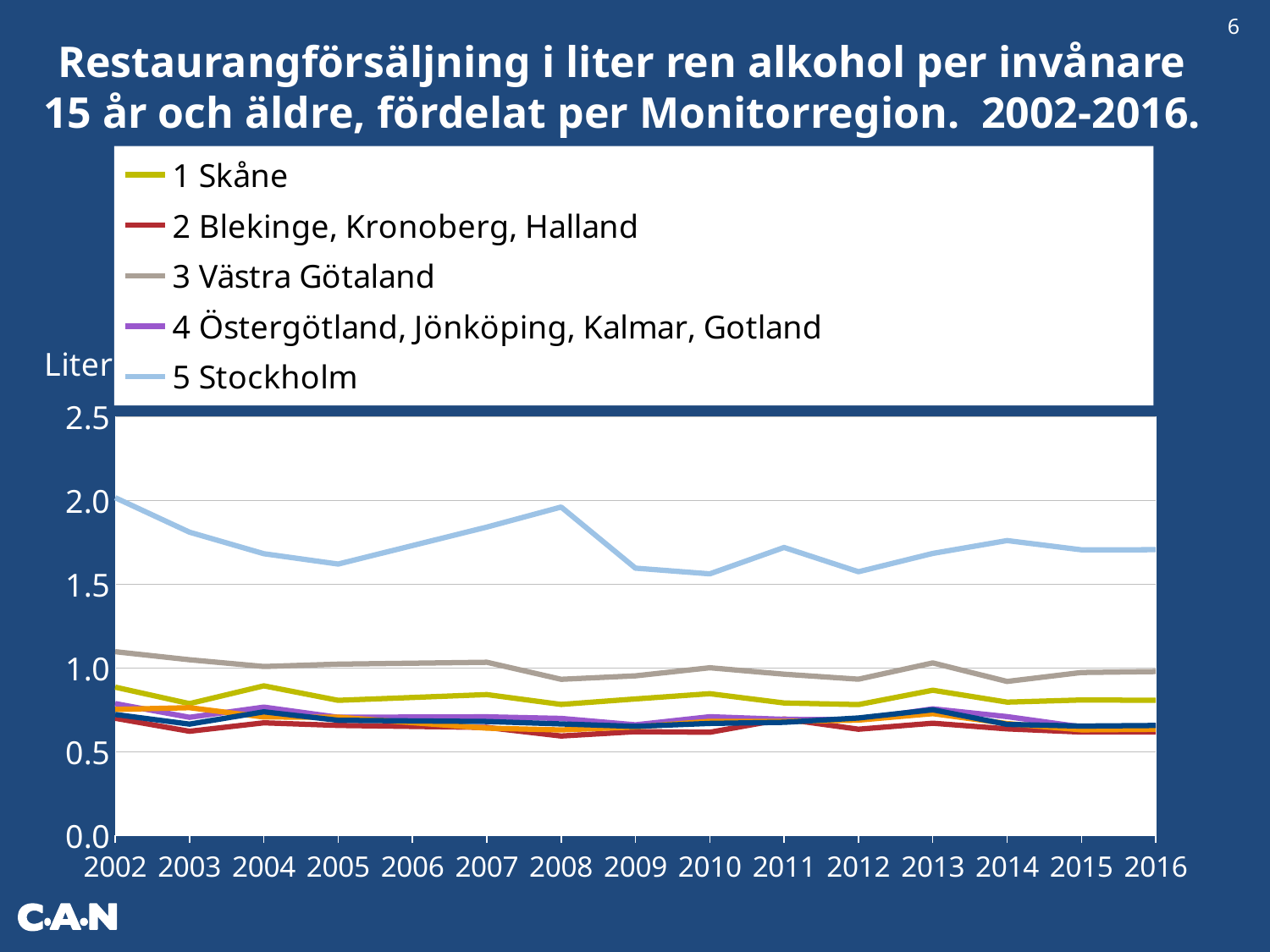
Is the value for 5 Stockholm in 2010 greater or less than 2.0? less How many years are shown on the x axis? 15 Does the value for 5 Stockholm rise or fall overall from 2002 to 2016? fall What is the label on the y axis? Liter What kind of chart is shown on the slide? line chart Is the value for 5 Stockholm in 2008 greater or less than 1.5? greater Is the value for 1 Skåne in 2016 greater or less than 1.0? less Which is larger in 2013, the value for 5 Stockholm or the value for 3 Västra Götaland? 5 Stockholm How many series does the legend list? 5 Which is larger in 2008, the value for 1 Skåne or the value for 2 Blekinge, Kronoberg, Halland? 1 Skåne Which region has the highest values throughout the period? 5 Stockholm